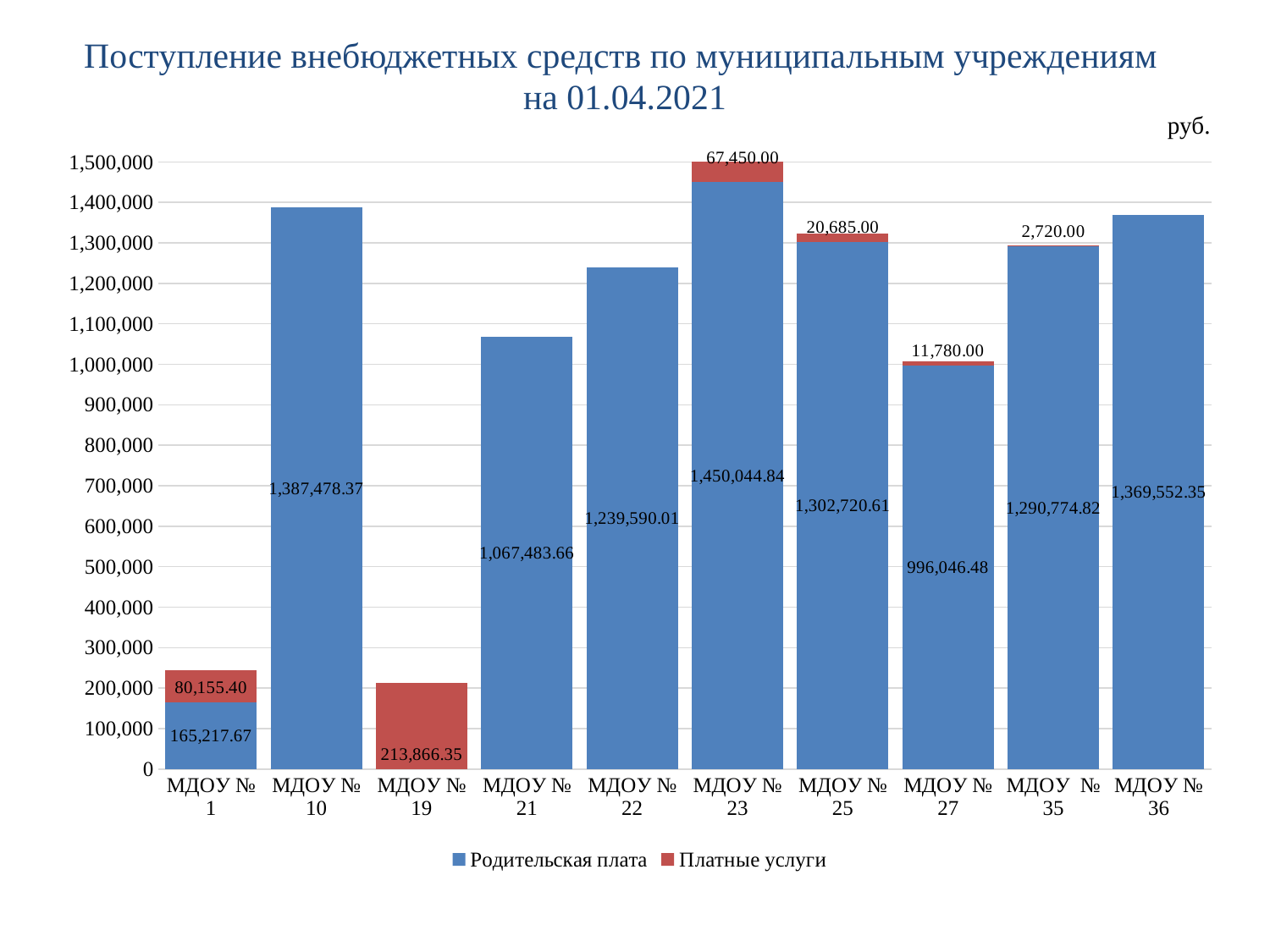
What is the difference in Родительская плата between МДОУ № 10 and МДОУ № 36? 17,926.02 Which has the larger Родительская плата, МДОУ № 21 or МДОУ № 22? МДОУ № 22 How many institutions (categories) are shown on the x axis? 10 What is the value of Родительская плата for МДОУ № 23? 1,450,044.84 Is the total bar for МДОУ № 27 greater or less than 1,000,000? greater What is the value of Платные услуги for МДОУ № 19? 213,866.35 What is the value of Платные услуги for МДОУ № 35? 2,720.00 Which institution has the highest Родительская плата? МДОУ № 23 Which institution has the lowest Платные услуги value shown? МДОУ № 35 How many series does the legend list? 2 What type of chart is shown on the slide? Stacked bar chart What is the total of the stacked bar for МДОУ № 1? 245,373.07